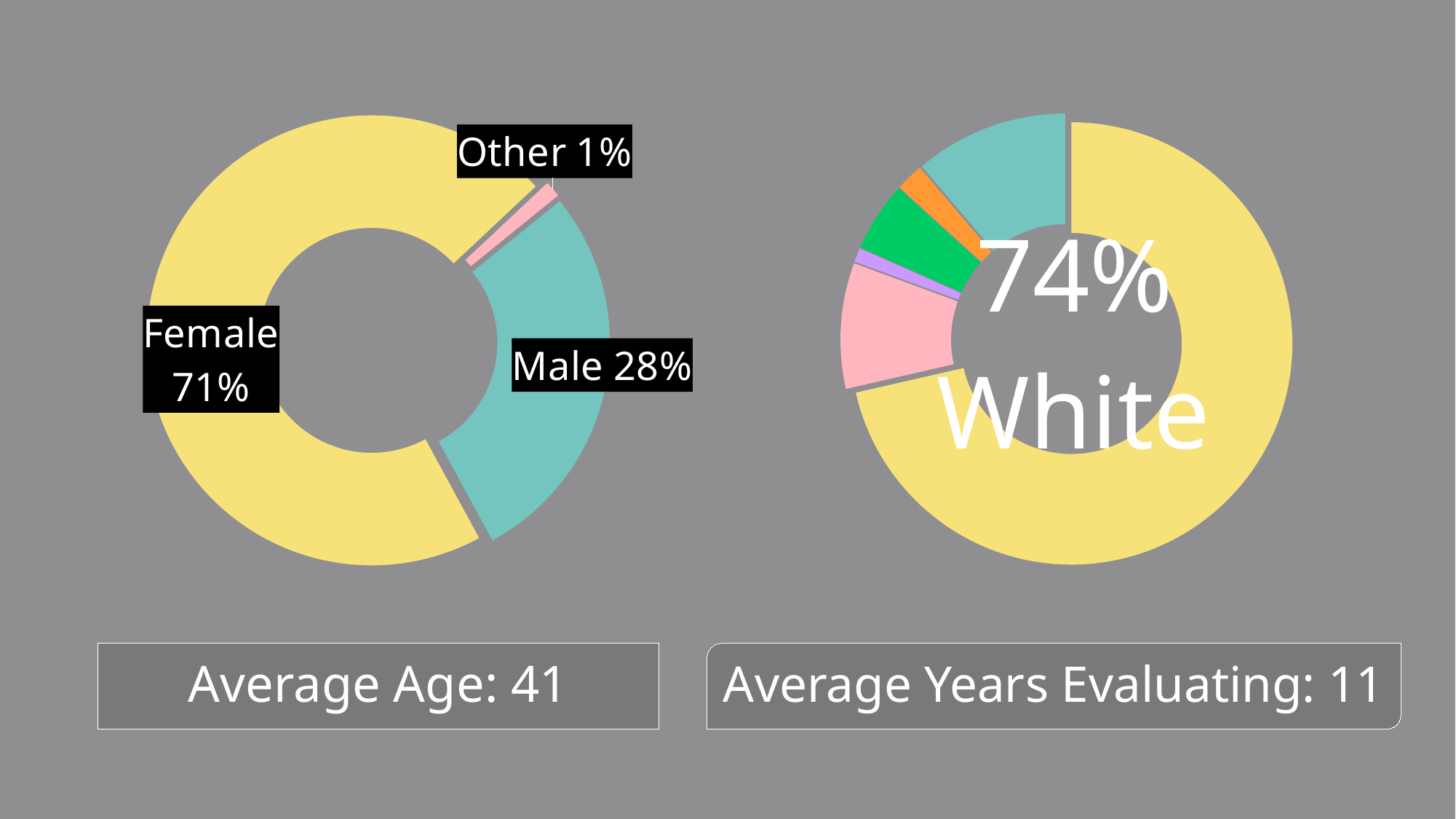
On the right chart, which category has the largest share? White On the right chart, what colour is the White slice? Yellow On the left chart, which category has the largest share? Female On the left chart, which category has the smallest share? Other How many categories does the left chart show? 3 On the left chart, what percentage is Female? 71% On the left chart, what is the difference in percentage points between Female and Male? 43 On the left chart, what percentage is Male? 28% What kind of chart is the left chart? Donut (pie) chart On the left chart, what percentage is Other? 1% On the right chart, what percentage is White? 74% On the left chart, which is larger, Male or Other? Male